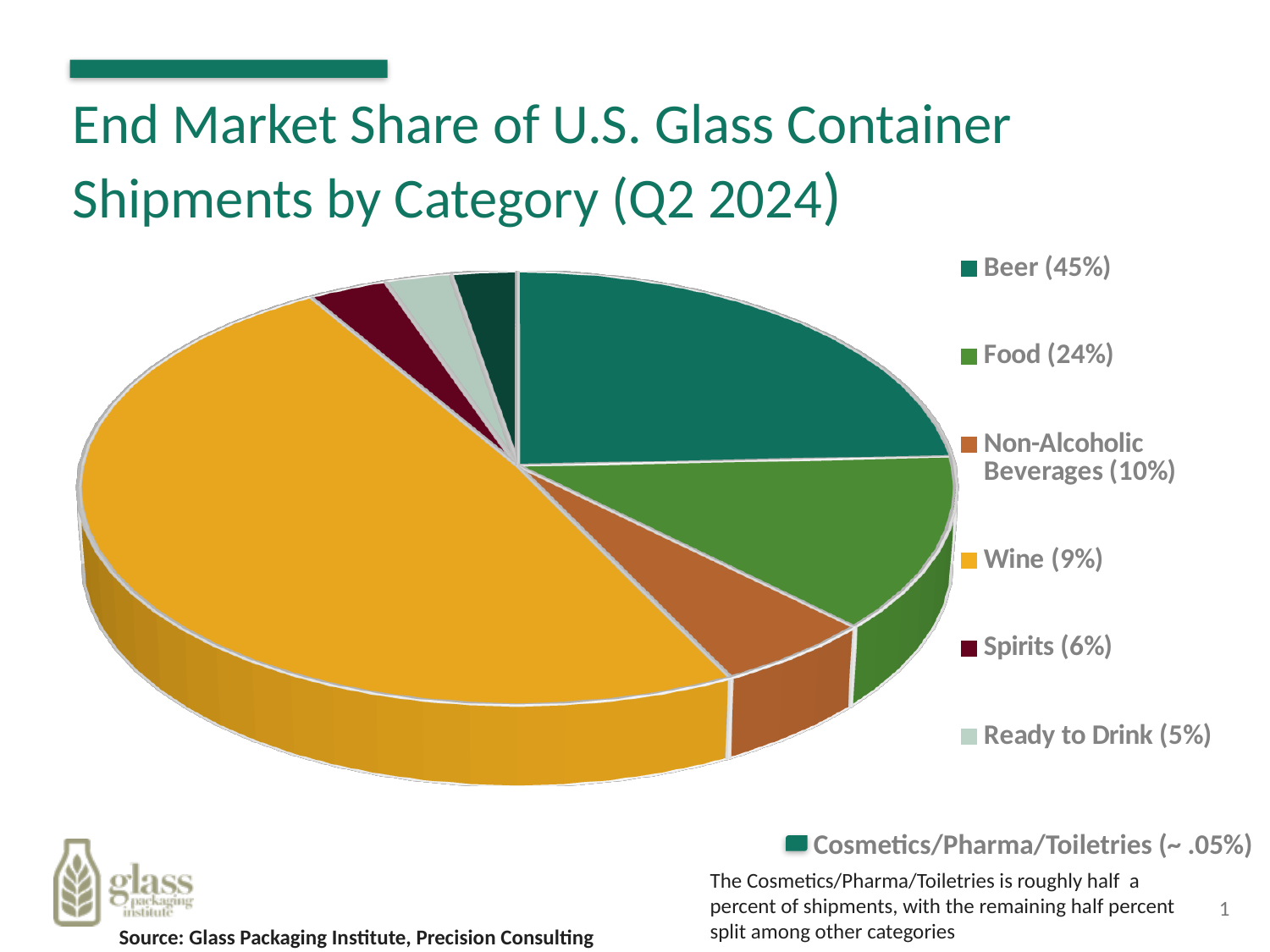
What share of U.S. glass container shipments does Beer account for? 45% What is the share for Wine? 9% What is the share for Ready to Drink? 5% What share of shipments does Food account for? 24% What is the title of the chart? End Market Share of U.S. Glass Container Shipments by Category (Q2 2024) What is the share for Non-Alcoholic Beverages? 10% How many categories are listed in the legend? 7 Which has a larger share, Spirits or Ready to Drink? Spirits How many percentage points larger is Beer's share than Food's share? 21% Which category has the largest share of shipments? Beer Which category has the smallest share of shipments? Cosmetics/Pharma/Toiletries What kind of chart is shown on the slide? pie chart